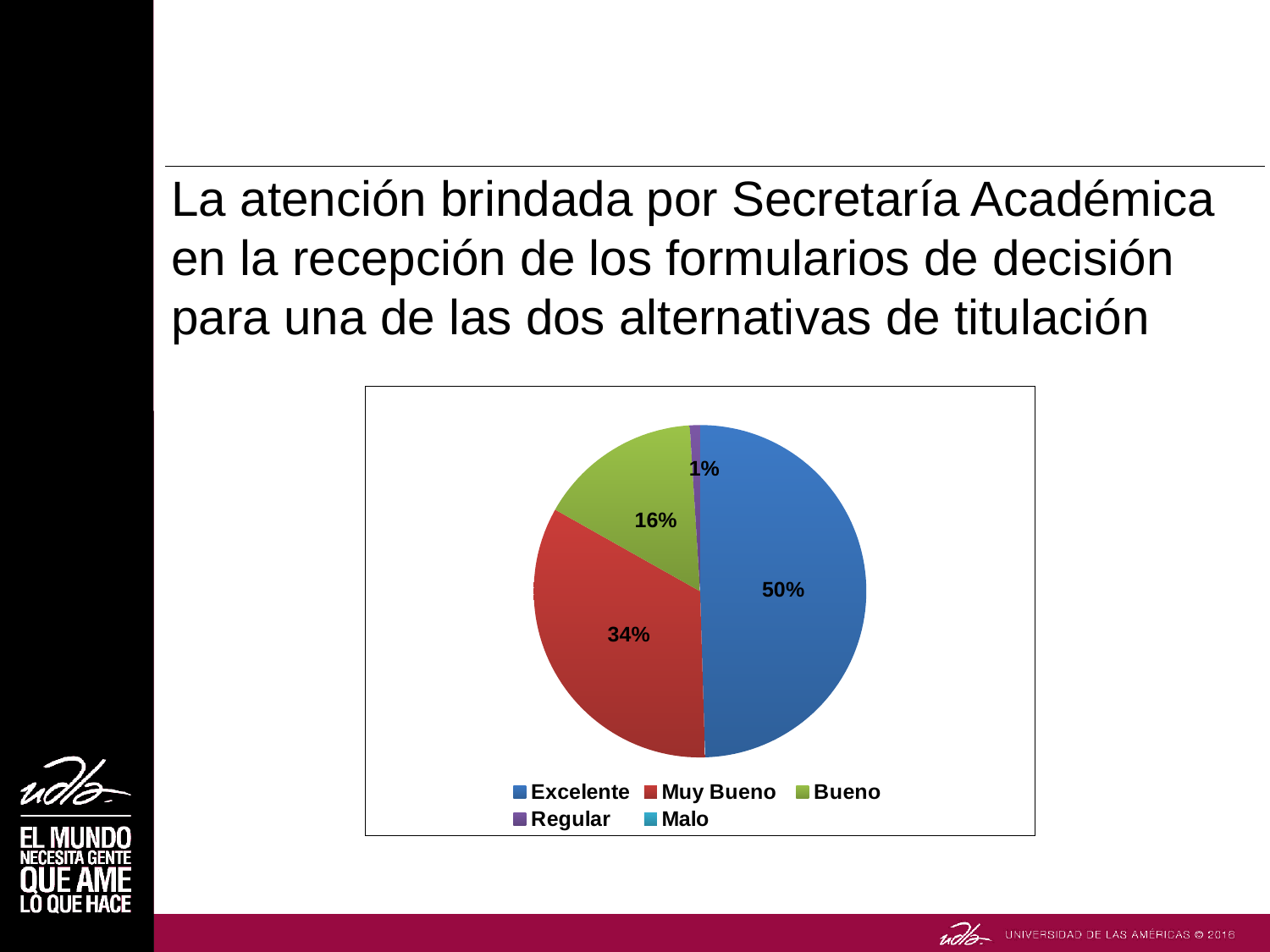
What colour is the Bueno slice? green Which is larger, the Muy Bueno slice or the Bueno slice? Muy Bueno What colour is the Excelente slice? blue What is the difference between the Excelente and Muy Bueno percentages? 16% What percentage of the pie corresponds to Muy Bueno? 34% What percentage of the pie corresponds to Regular? 1% What type of chart is shown on the slide? pie chart What percentage of the pie corresponds to Bueno? 16% How many categories does the legend list? 5 Which labelled slice of the pie is the smallest? Regular Which category has the largest slice of the pie? Excelente What percentage of the pie corresponds to Excelente? 50%